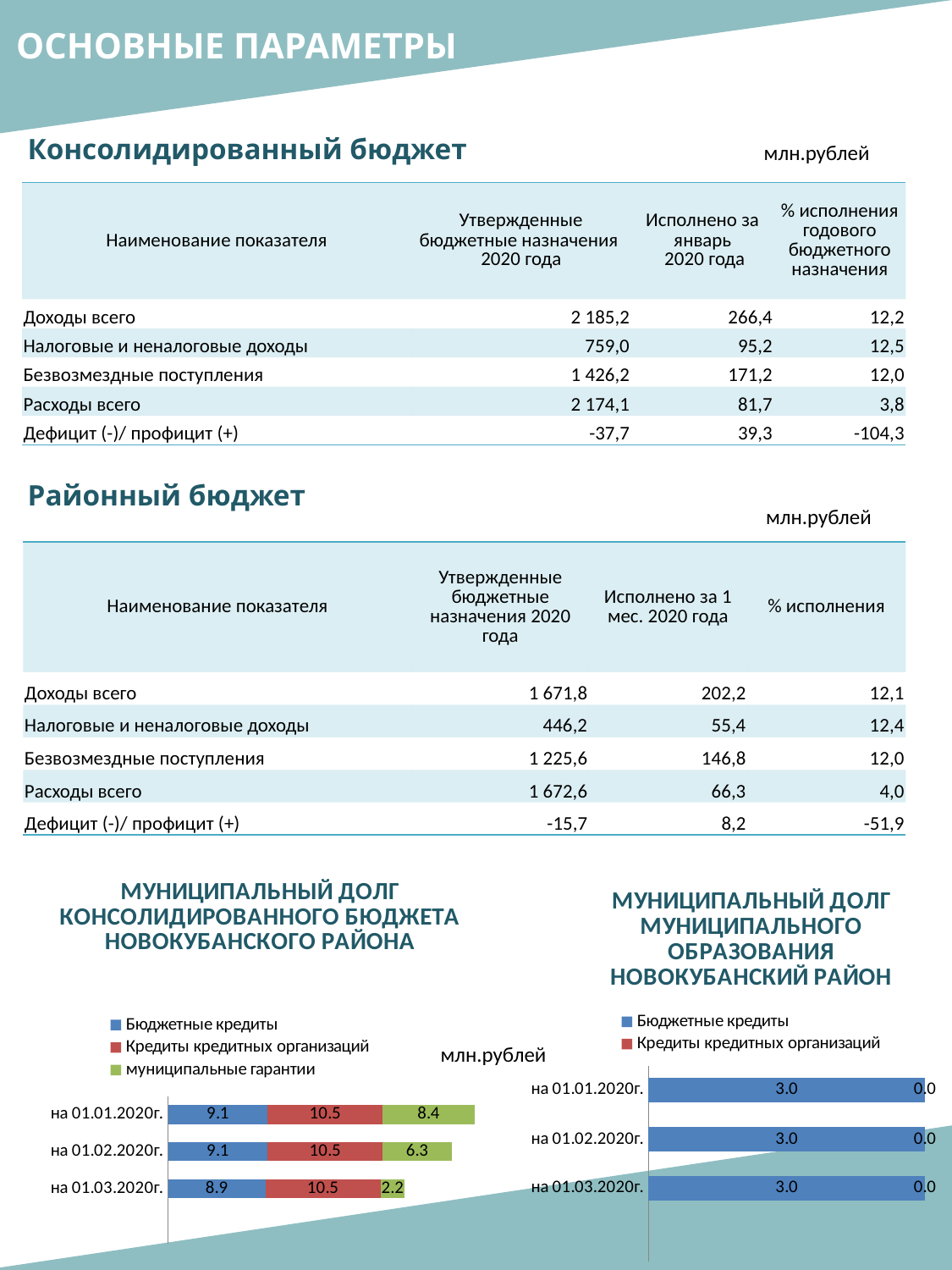
In the left chart (Муниципальный долг консолидированного бюджета Новокубанского района), does муниципальные гарантии rise or fall from 01.01.2020 to 01.03.2020? fall In the left chart (Муниципальный долг консолидированного бюджета Новокубанского района), what is the total of the stacked bar for 01.02.2020? 25.9 In the left chart (Муниципальный долг консолидированного бюджета Новокубанского района), what is the value of Кредиты кредитных организаций on 01.02.2020? 10.5 In the right chart (Муниципальный долг муниципального образования Новокубанский район), what is the value of Кредиты кредитных организаций on 01.03.2020? 0.0 In the right chart (Муниципальный долг муниципального образования Новокубанский район), how many dates are shown on the axis? 3 In the left chart (Муниципальный долг консолидированного бюджета Новокубанского района), what is the value of муниципальные гарантии on 01.01.2020? 8.4 In the left chart (Муниципальный долг консолидированного бюджета Новокубанского района), how many series does the legend list? 3 In the right chart (Муниципальный долг муниципального образования Новокубанский район), what is the value of Бюджетные кредиты on 01.02.2020? 3.0 In the left chart (Муниципальный долг консолидированного бюджета Новокубанского района), what is the difference between муниципальные гарантии on 01.01.2020 and on 01.03.2020? 6.2 In the left chart (Муниципальный долг консолидированного бюджета Новокубанского района), on which date is муниципальные гарантии lowest? на 01.03.2020г. What type of chart is the right chart (Муниципальный долг муниципального образования Новокубанский район)? bar chart In the left chart (Муниципальный долг консолидированного бюджета Новокубанского района), what is the value of Бюджетные кредиты on 01.03.2020? 8.9